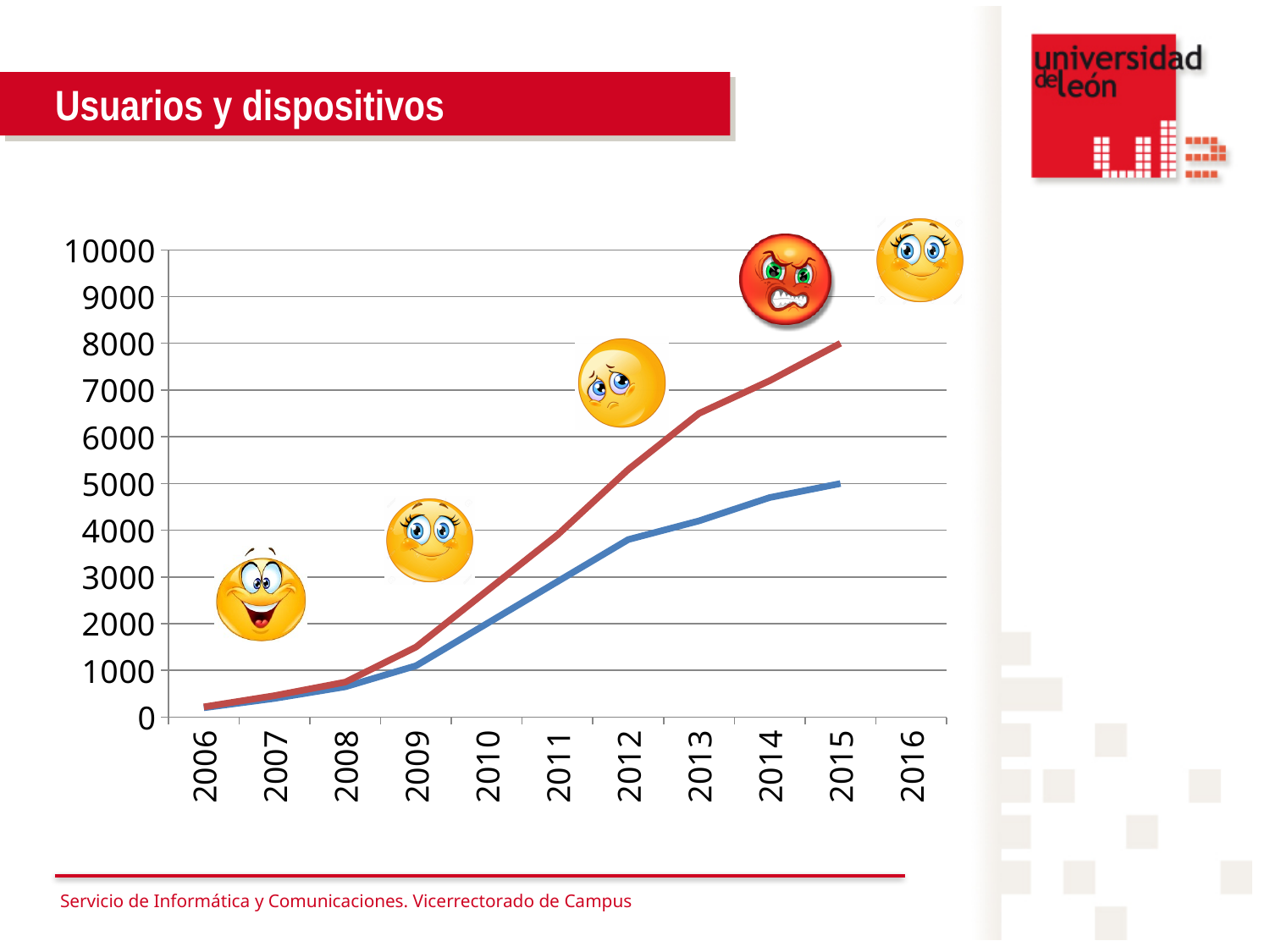
How many years are labelled on the x axis? 11 What is the title shown above the chart on the slide? Usuarios y dispositivos In 2014, which line has the higher value, the red line or the blue line? the red line Does the red line rise or fall from 2006 to 2015? rise Is the value of the red line in 2015 greater or less than 7000? greater How many lines are plotted on the chart? 2 Is the value of the blue line in 2010 greater or less than 3000? less Is the value of the red line in 2009 greater or less than 2000? less Does the blue line rise or fall from 2006 to 2015? rise What kind of chart is shown on the slide? line chart